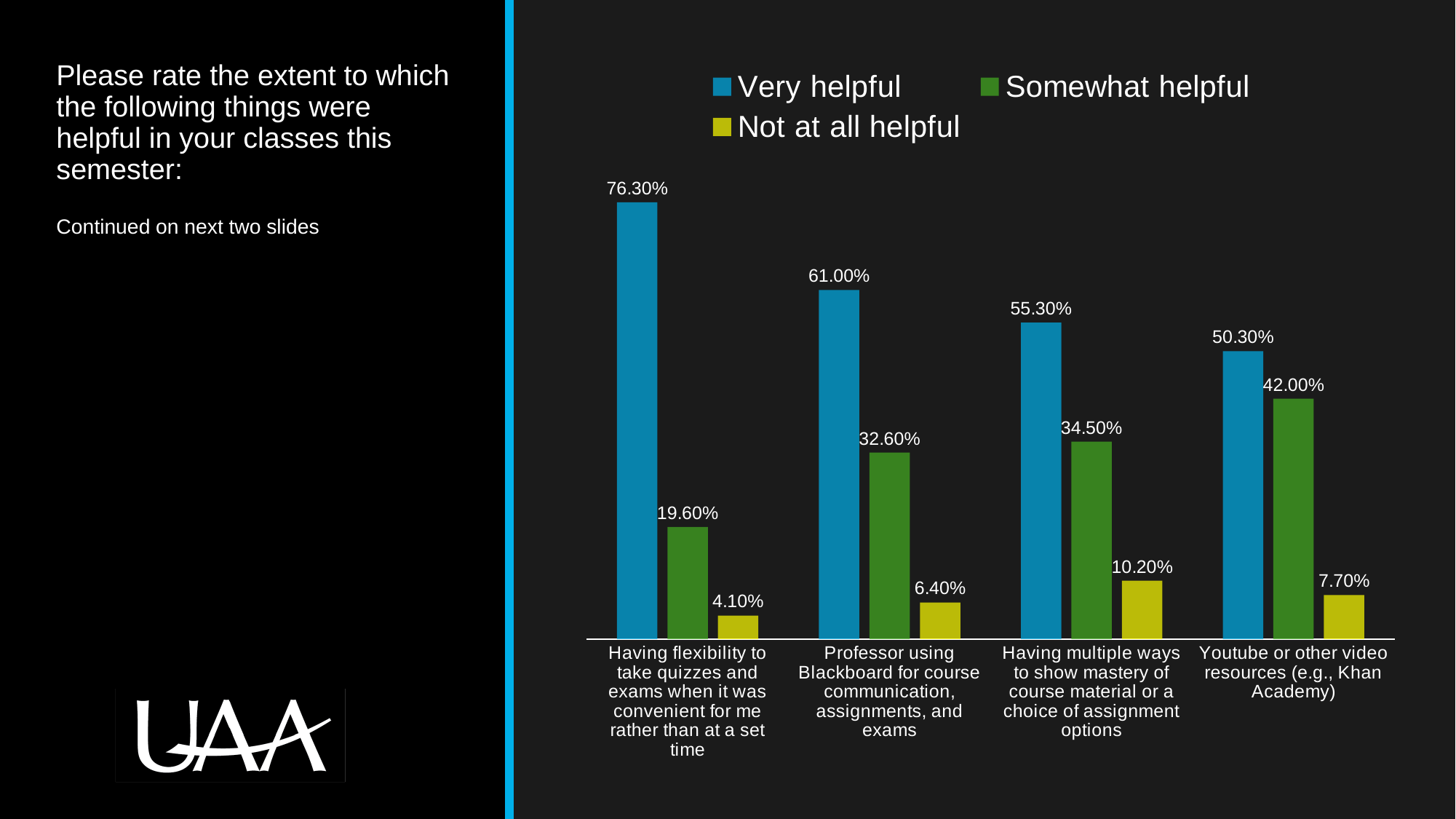
Which is larger: the Somewhat helpful value for 'Professor using Blackboard for course communication, assignments, and exams' or for 'Having multiple ways to show mastery of course material or a choice of assignment options'? Having multiple ways to show mastery of course material or a choice of assignment options Which colour represents the 'Not at all helpful' series in the legend? Yellow How many series does the legend list? 3 What is the Very helpful value for 'Youtube or other video resources (e.g., Khan Academy)'? 50.30% What kind of chart is shown on the slide? Bar chart Which category has the highest Very helpful percentage? Having flexibility to take quizzes and exams when it was convenient for me rather than at a set time How many categories are shown on the x axis of the chart? 4 What is the difference between the Very helpful and Somewhat helpful values for 'Youtube or other video resources (e.g., Khan Academy)'? 8.30% What percentage rated 'Having flexibility to take quizzes and exams when it was convenient for me rather than at a set time' as Very helpful? 76.30% What is the Not at all helpful value for 'Having multiple ways to show mastery of course material or a choice of assignment options'? 10.20% What is the Somewhat helpful value for 'Professor using Blackboard for course communication, assignments, and exams'? 32.60% Which category has the lowest Not at all helpful percentage? Having flexibility to take quizzes and exams when it was convenient for me rather than at a set time